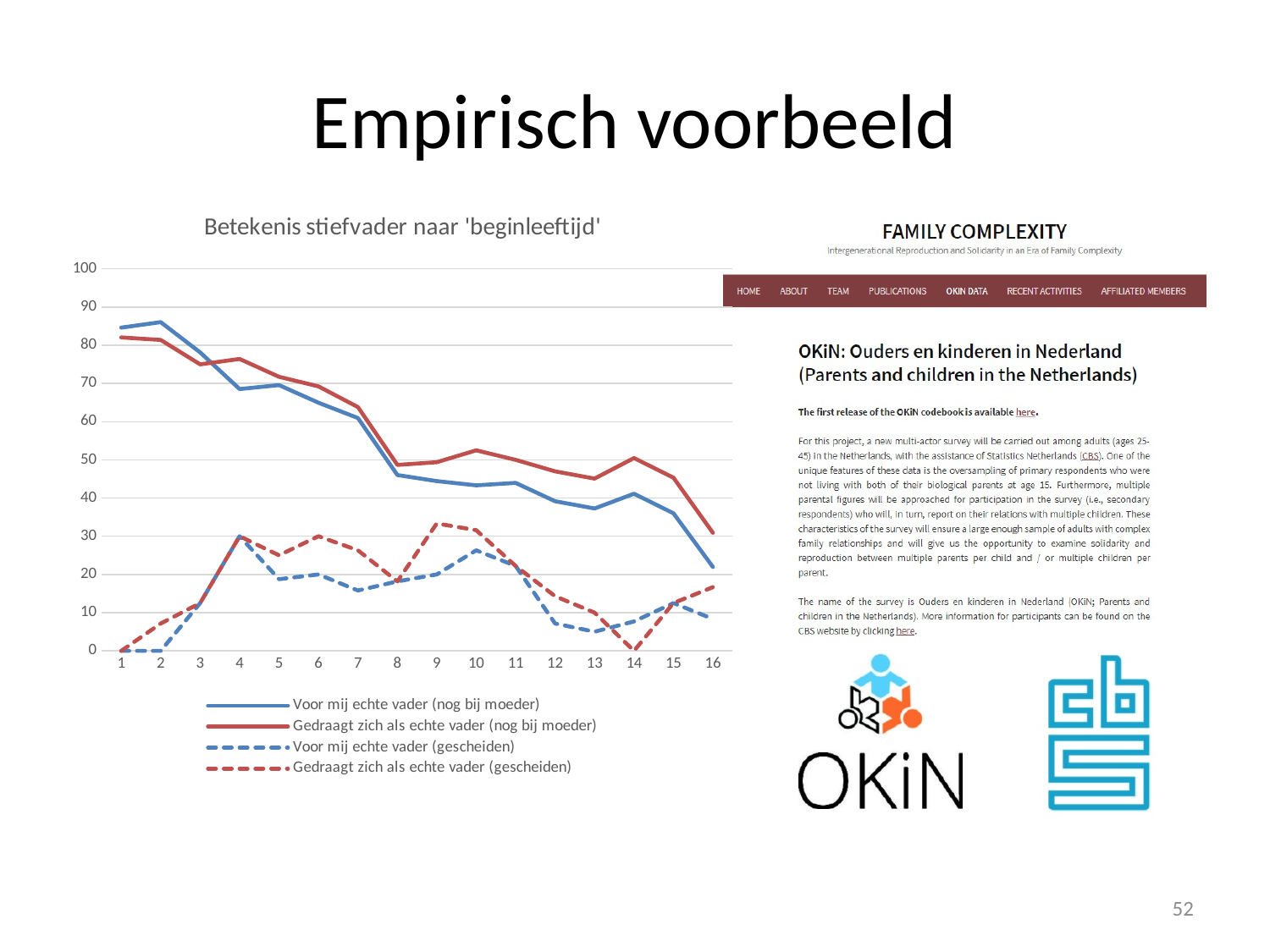
Is the value for 'Voor mij echte vader (nog bij moeder)' at x = 12 greater or less than 50? less Is the value for 'Gedraagt zich als echte vader (gescheiden)' at x = 14 greater or less than 10? less Which series has the lowest value at x = 16? Voor mij echte vader (gescheiden) At x = 14, which series has the higher value: 'Gedraagt zich als echte vader (nog bij moeder)' or 'Voor mij echte vader (nog bij moeder)'? Gedraagt zich als echte vader (nog bij moeder) Does the line for 'Voor mij echte vader (nog bij moeder)' rise or fall from x = 1 to x = 16? fall At x = 9, which series has the higher value: 'Voor mij echte vader (gescheiden)' or 'Gedraagt zich als echte vader (gescheiden)'? Gedraagt zich als echte vader (gescheiden) Is the value for 'Gedraagt zich als echte vader (nog bij moeder)' at x = 16 greater or less than 40? less How many series does the legend of the chart list? 4 How many points are there along the x axis of the chart? 16 What is the title of the chart? Betekenis stiefvader naar 'beginleeftijd' What kind of chart is shown on the slide? line chart